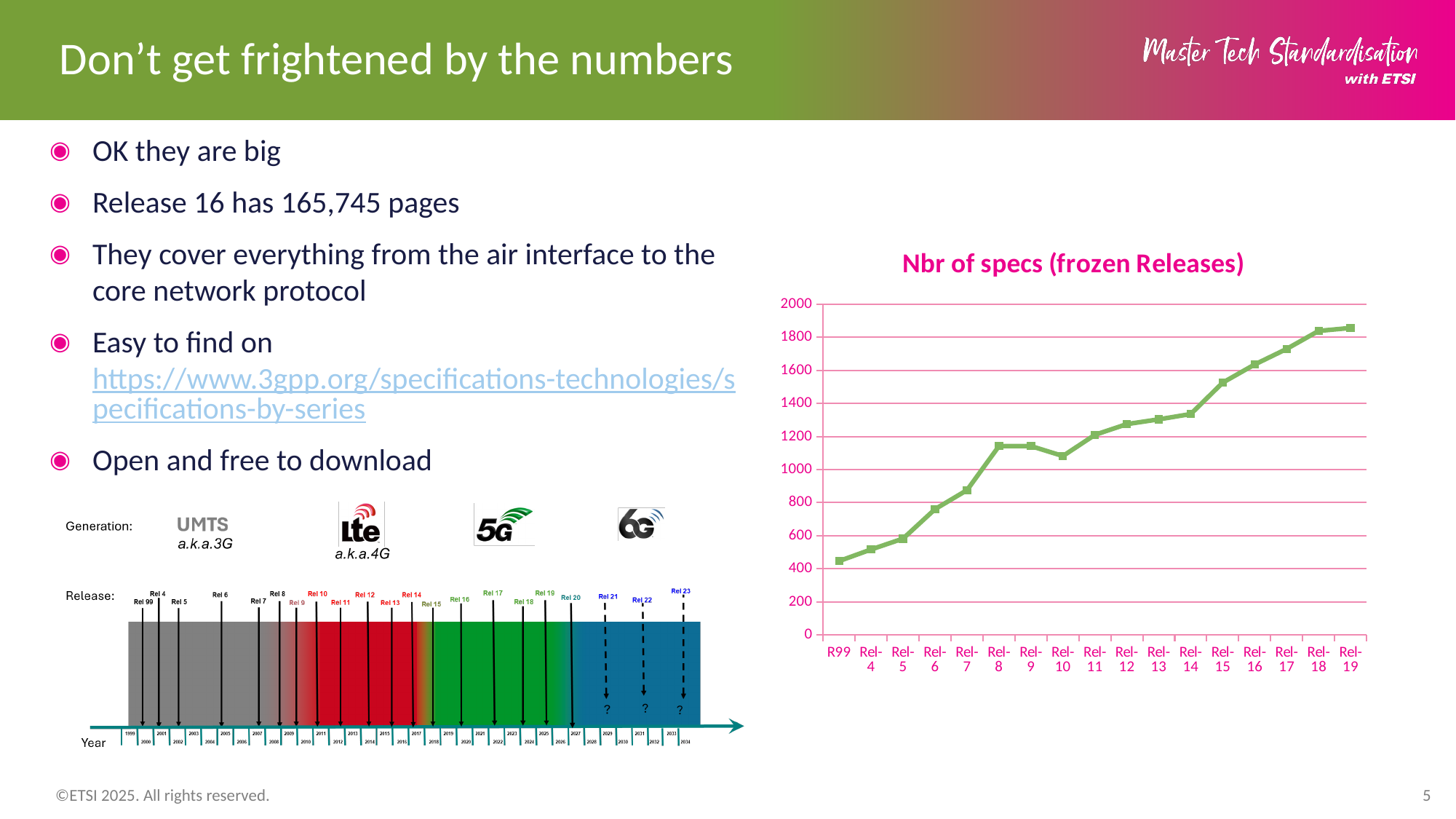
In the 'Nbr of specs (frozen Releases)' chart, which has more specs, Rel-14 or Rel-15? Rel-15 In the 'Nbr of specs (frozen Releases)' chart, is the value for Rel-15 greater or less than 1400? greater In the 'Nbr of specs (frozen Releases)' chart, which has more specs, Rel-7 or Rel-8? Rel-8 In the 'Nbr of specs (frozen Releases)' chart, is the value for Rel-19 greater or less than 1800? greater What is the title of the chart on the right of the slide? Nbr of specs (frozen Releases) How many releases are plotted on the x axis of the 'Nbr of specs (frozen Releases)' chart? 17 In the 'Nbr of specs (frozen Releases)' chart, is the value for Rel-8 greater or less than 1000? greater In the 'Nbr of specs (frozen Releases)' chart, do the values generally rise or fall from R99 to Rel-19? rise What kind of chart is the 'Nbr of specs (frozen Releases)' chart? line chart In the 'Nbr of specs (frozen Releases)' chart, which release has the lowest number of specs? R99